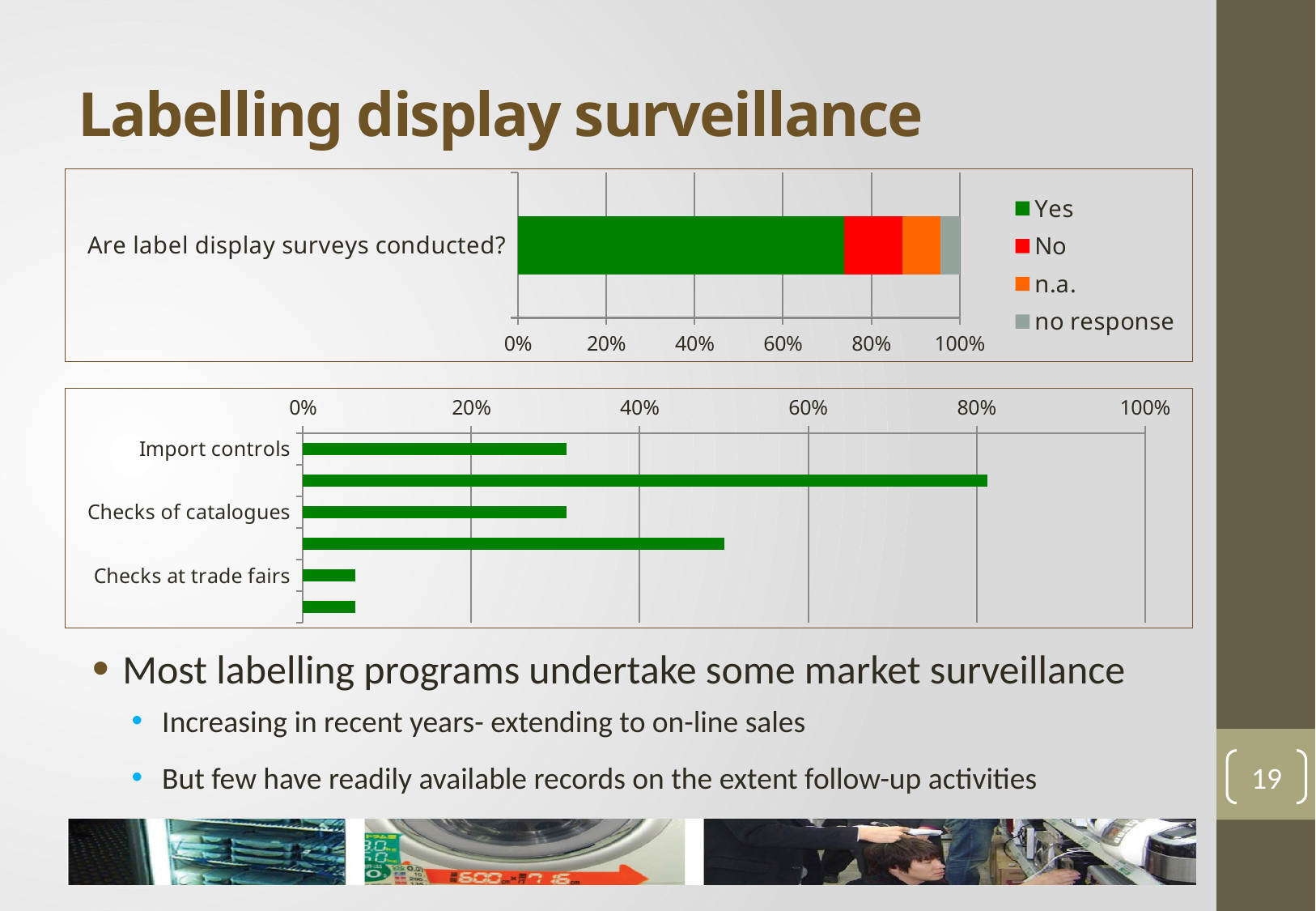
In the bottom chart, which is larger: 'Checks of catalogues' or 'Checks at trade fairs'? Checks of catalogues What kind of chart is the top chart titled 'Are label display surveys conducted?'? bar chart In the top chart, which legend entry is shown in green? Yes How many series does the legend of the top chart list? 4 In the bottom chart, which of the labelled categories has the lowest value? Checks at trade fairs In the bottom chart, is the value for 'Checks at trade fairs' greater or less than 20%? less What kind of chart is the bottom chart? bar chart In the top chart, which response category has the largest share of the bar? Yes In the bottom chart, is the value for 'Import controls' greater or less than 40%? less In the top chart, is the value for 'Yes' greater or less than 60%? greater How many bars are plotted in the bottom chart? 6